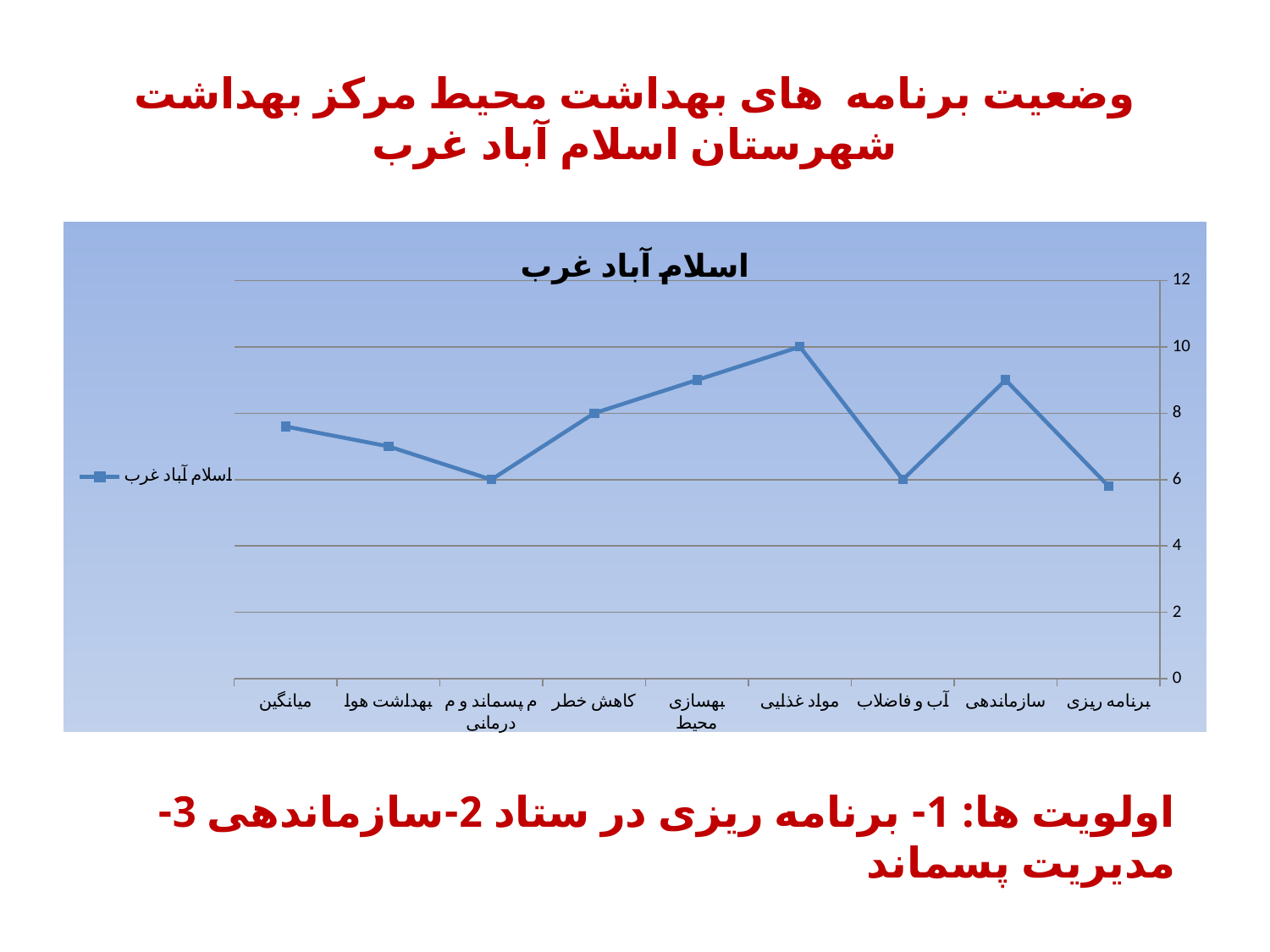
What is the value for کاهش خطر? 8 Which category has the highest value? مواد غذایی Is the value for بهسازی محیط greater or less than 8? greater What is the title of the chart? اسلام آباد غرب How many categories are plotted along the x axis? 9 What is the value for مواد غذایی? 10 How many series does the legend list? 1 Is the value for برنامه ریزی greater or less than 8? less What is the value for آب و فاضلاب? 6 What kind of chart is shown on the slide? line chart Which is larger, the value for سازماندهی or the value for آب و فاضلاب? سازماندهی What is the difference between the values for مواد غذایی and کاهش خطر? 2